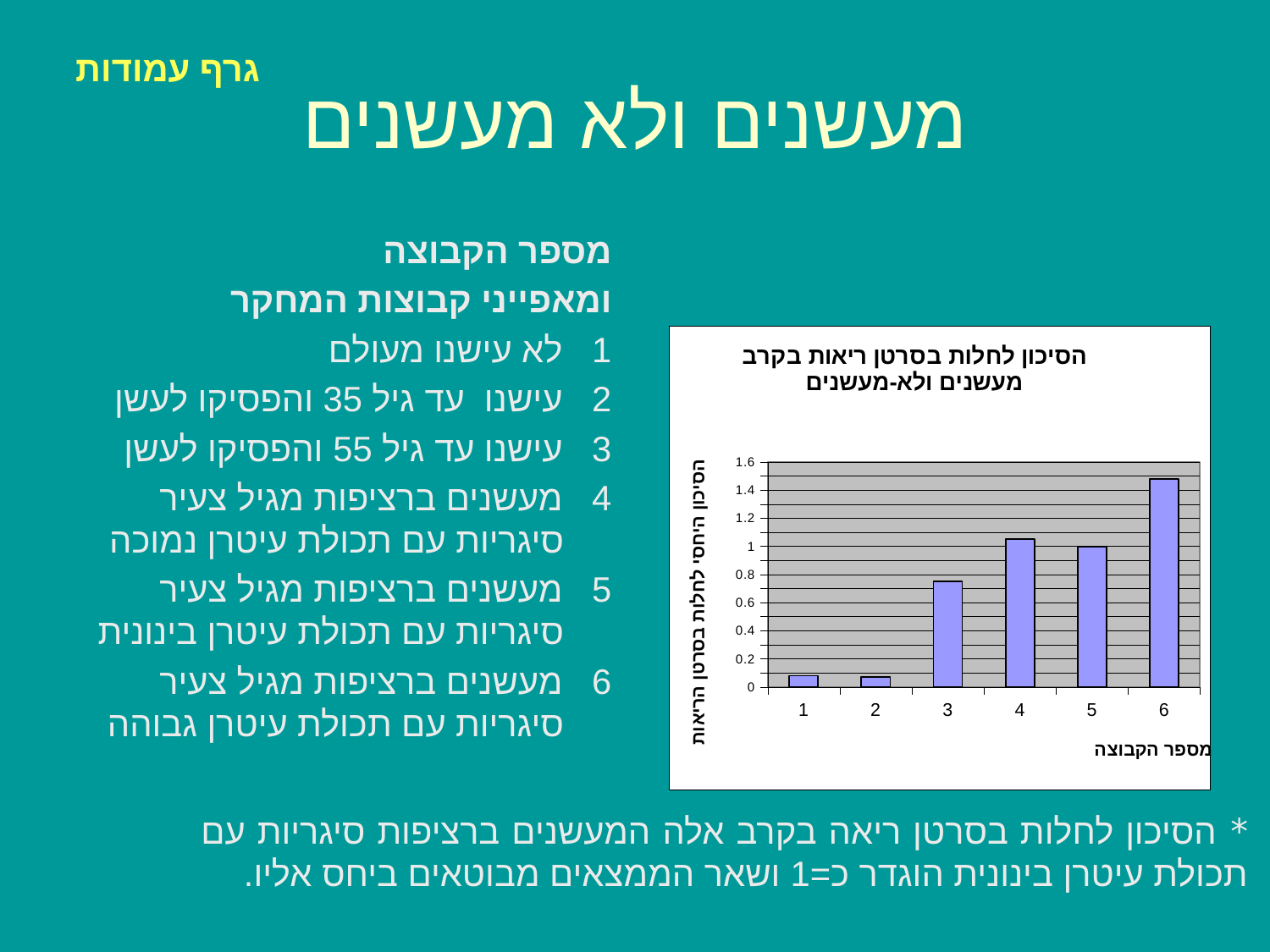
How many groups (categories) are plotted on the x axis of the chart? 6 What kind of chart is shown on the slide? Bar chart Which has a larger value in the chart, group 3 or group 4? Group 4 Do the bar values generally rise or fall from group 1 to group 6? Rise What is the label of the x axis of the chart? מספר הקבוצה Is the value for group 3 greater or less than 0.6? greater Which group number has the highest bar in the chart? 6 Is the value for group 6 greater or less than 1.4? greater Is the value for group 4 greater or less than 1? greater Which has a larger value in the chart, group 4 or group 6? Group 6